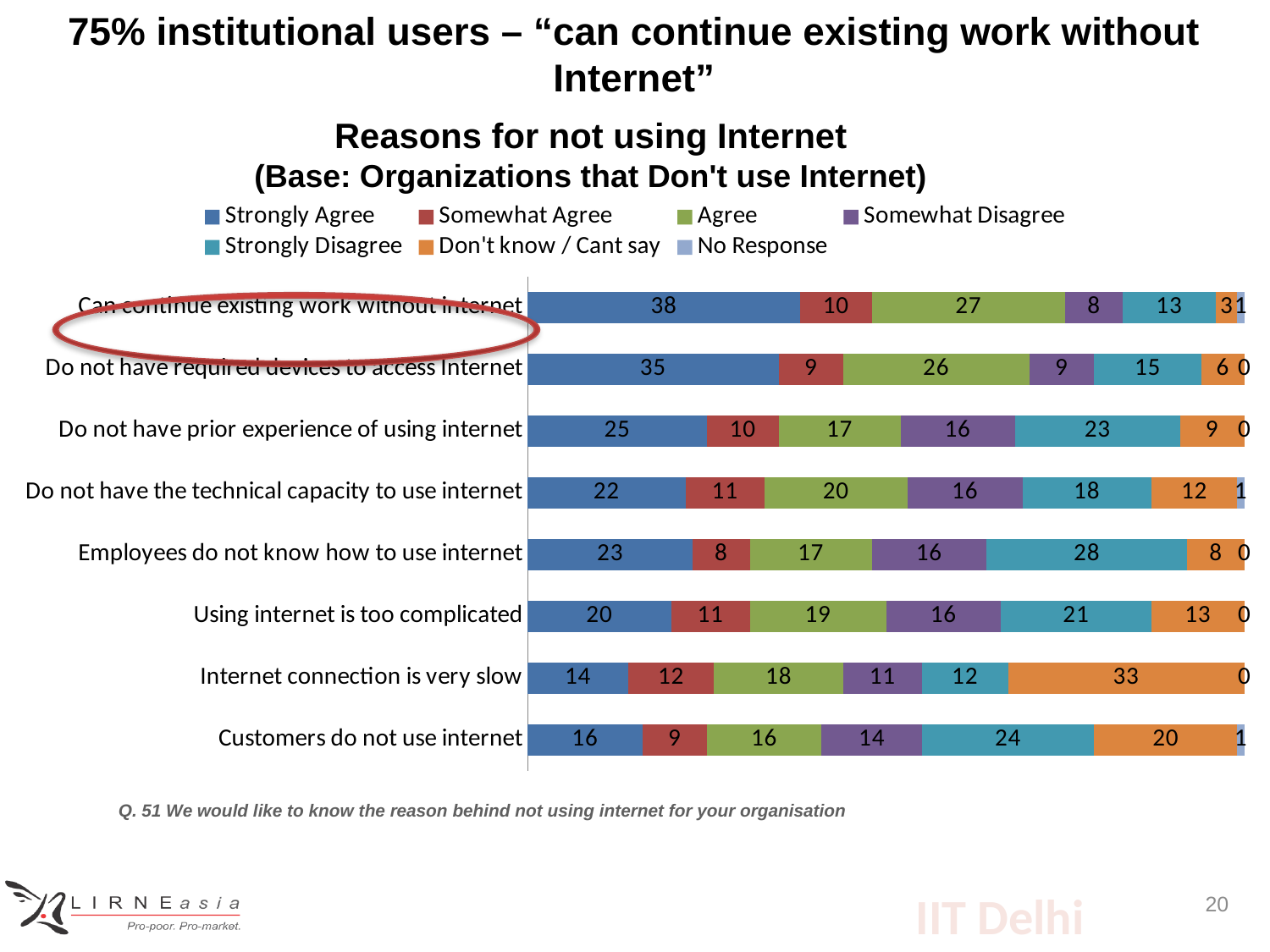
Which reason has the highest Strongly Agree value? Can continue existing work without internet What is the Strongly Disagree value for "Employees do not know how to use internet"? 28 What is the total of the stacked bar for "Internet connection is very slow"? 100 Which reason has the lowest Strongly Agree value? Internet connection is very slow How many series does the legend list? 7 What is the title of the chart? Reasons for not using Internet (Base: Organizations that Don't use Internet) How many reasons (categories) are plotted in the chart? 8 What type of chart is shown on the slide? Stacked bar chart Which has a larger Strongly Disagree value: "Customers do not use internet" or "Do not have the technical capacity to use internet"? Customers do not use internet What is the difference between the Agree values for "Can continue existing work without internet" and "Do not have prior experience of using internet"? 10 What is the Don't know / Cant say value for "Internet connection is very slow"? 33 What is the Strongly Agree value for "Can continue existing work without internet"? 38